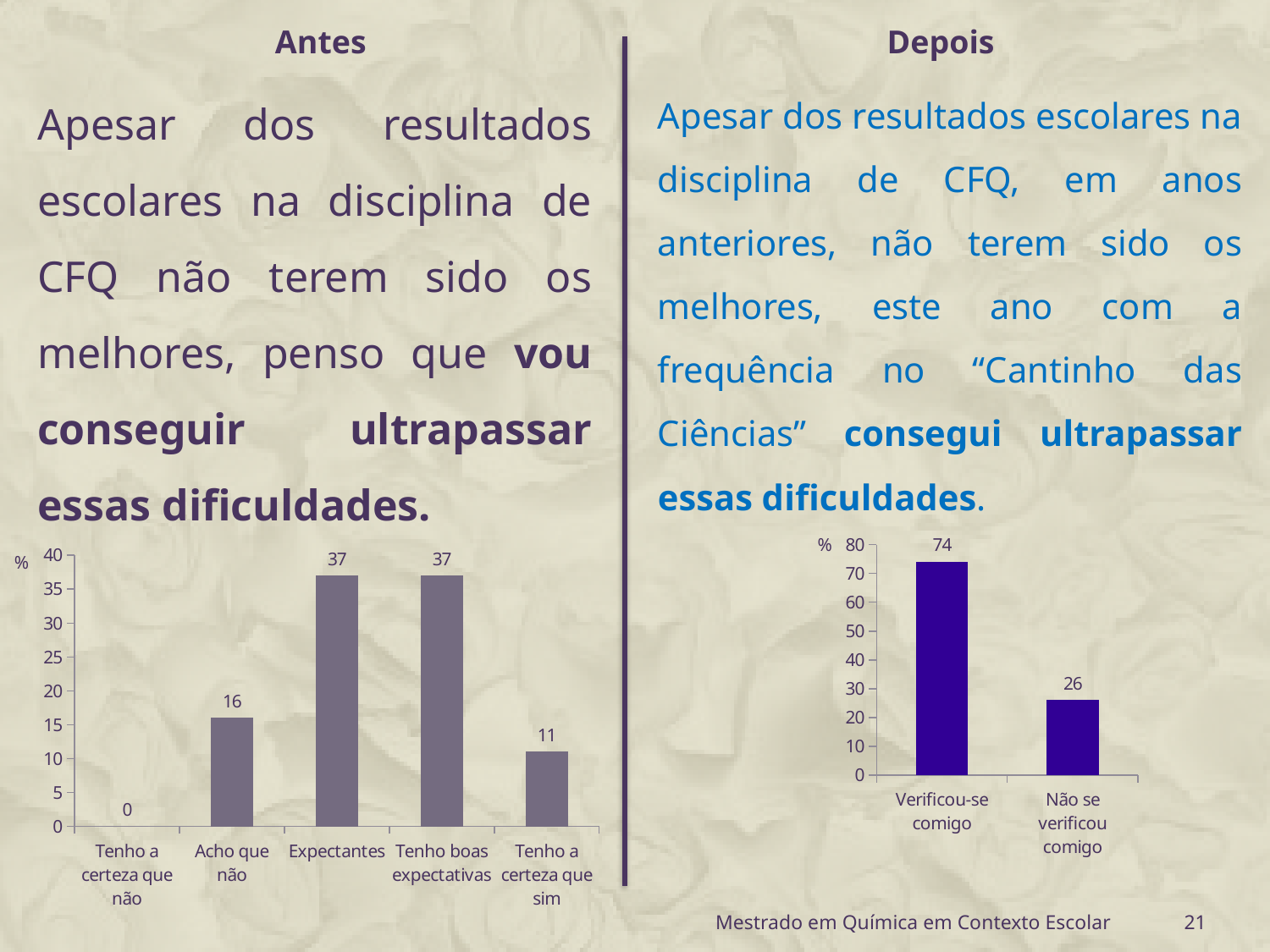
In the left chart, what is the value for "Tenho a certeza que sim"? 11 In the left chart, what is the difference between the values for "Expectantes" and "Acho que não"? 21 In the left chart, what is the value for "Acho que não"? 16 In the right chart, what is the value for "Não se verificou comigo"? 26 In the right chart, which category has the highest value? Verificou-se comigo In the right chart, what is the difference between the values for "Verificou-se comigo" and "Não se verificou comigo"? 48 In the left chart, which category has the lowest value? Tenho a certeza que não How many categories are shown in the left chart? 5 In the left chart, what is the value for "Tenho a certeza que não"? 0 In the left chart, which is larger: the value for "Acho que não" or the value for "Tenho a certeza que sim"? Acho que não In the right chart, what is the value for "Verificou-se comigo"? 74 What kind of chart is the left chart? Bar chart